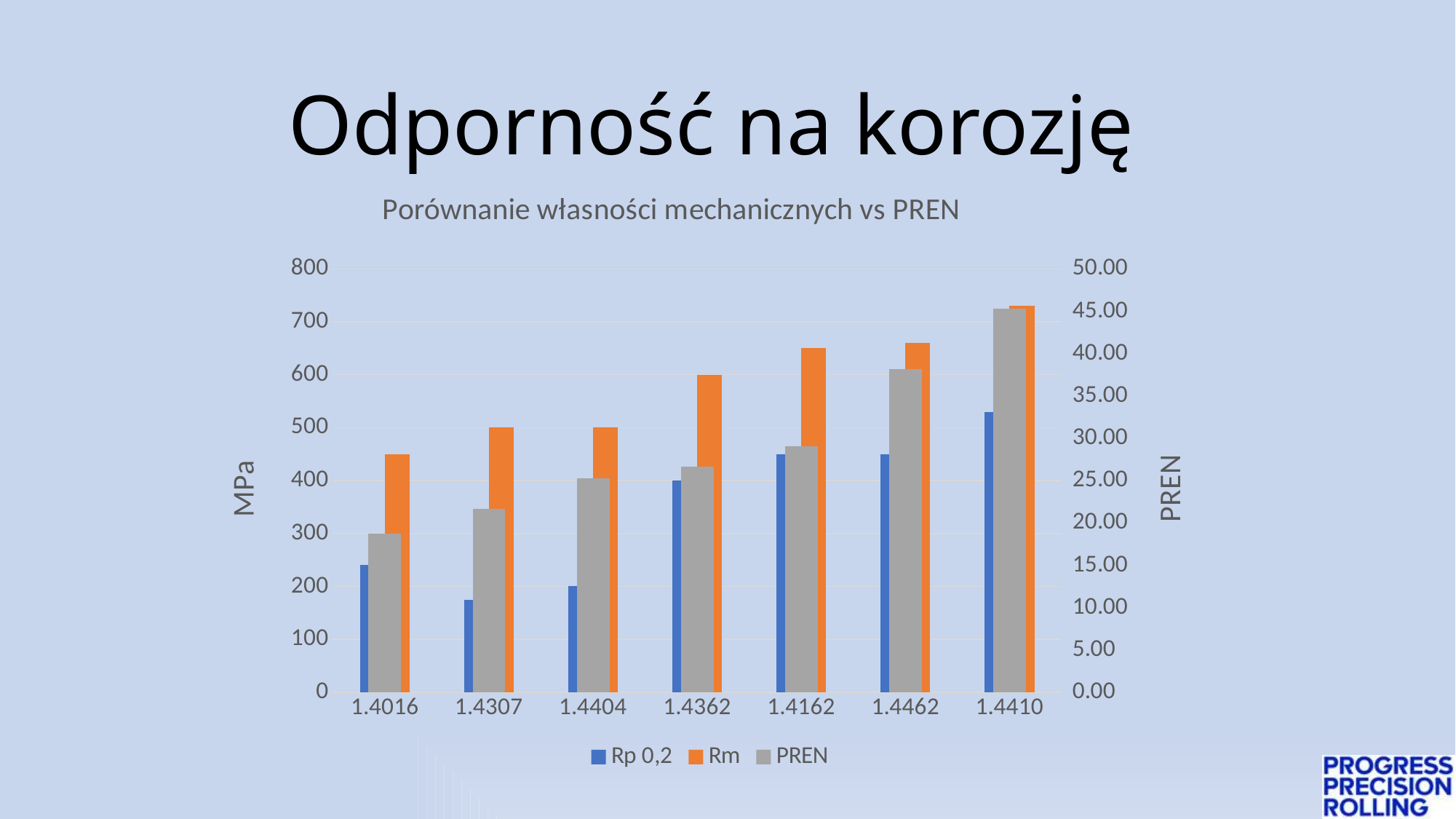
How many series does the legend list? 3 Is the Rp 0,2 value for 1.4410 greater or less than 500? greater For 1.4362, which is larger: Rm or Rp 0,2? Rm Which category has the lowest Rp 0,2 value? 1.4307 Do the PREN values rise or fall from left to right along the x axis? rise Is the Rp 0,2 value for 1.4016 greater or less than 300? less How many steel grades (categories) are shown on the x axis? 7 What kind of chart is shown on the slide? bar chart What is the label of the left vertical axis? MPa What is the title of the chart? Porównanie własności mechanicznych vs PREN Which category has the highest Rm value? 1.4410 Is the Rm value for 1.4016 greater or less than 400? greater